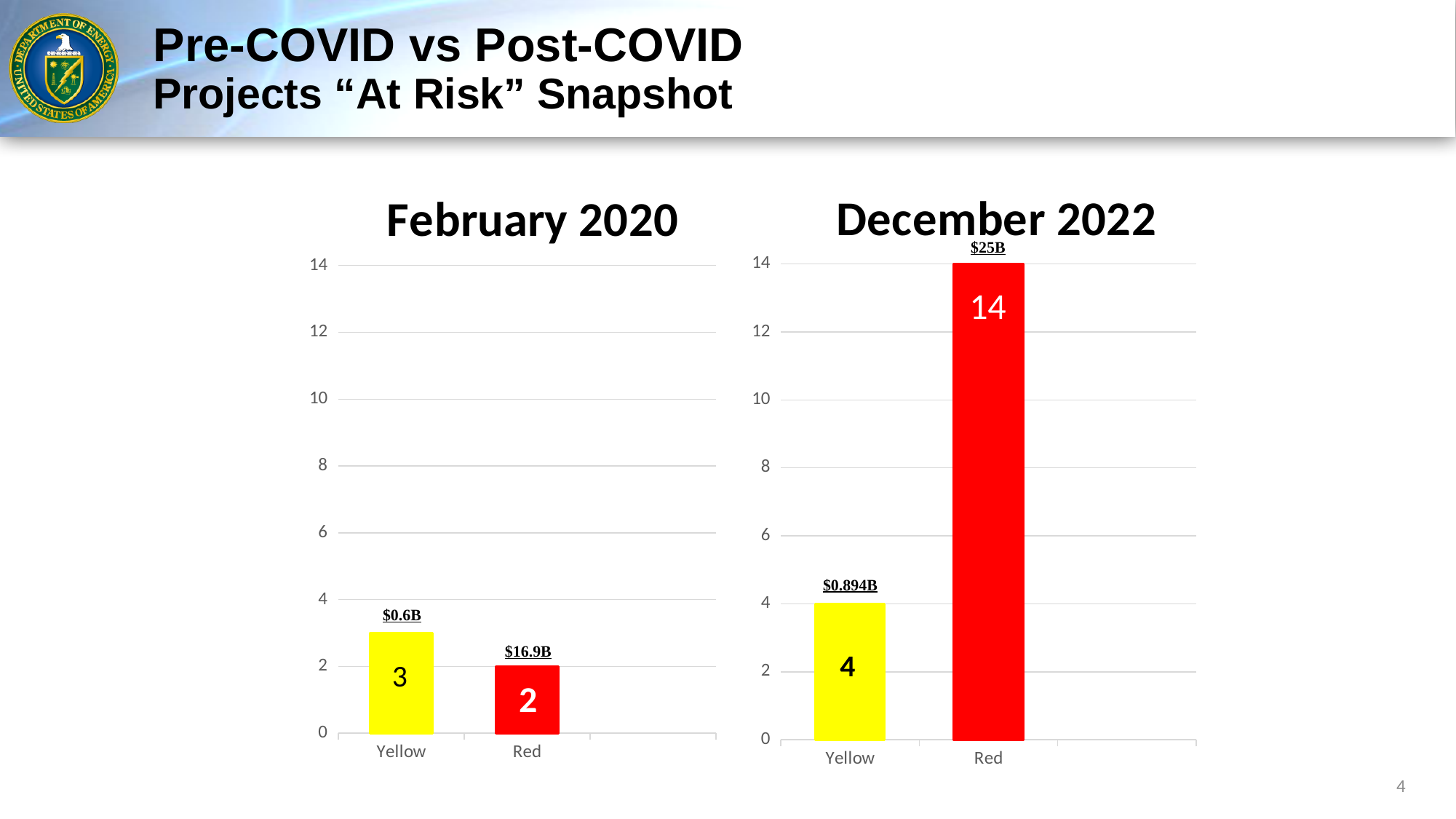
In the December 2022 chart, what is the value for Yellow? 4 In the December 2022 chart, is the value for Red greater or less than 10? greater In the February 2020 chart, what is the value for Red? 2 What kind of chart is the December 2022 chart? bar chart In the December 2022 chart, what dollar amount is labelled above the Red bar? $25B In the February 2020 chart, what is the value for Yellow? 3 In the December 2022 chart, what is the value for Red? 14 In the December 2022 chart, which category has the highest value? Red In the February 2020 chart, which is larger, Yellow or Red? Yellow How many categories does the February 2020 chart show? 2 In the December 2022 chart, what is the difference between the Red and Yellow values? 10 In the February 2020 chart, which category has the lowest value? Red